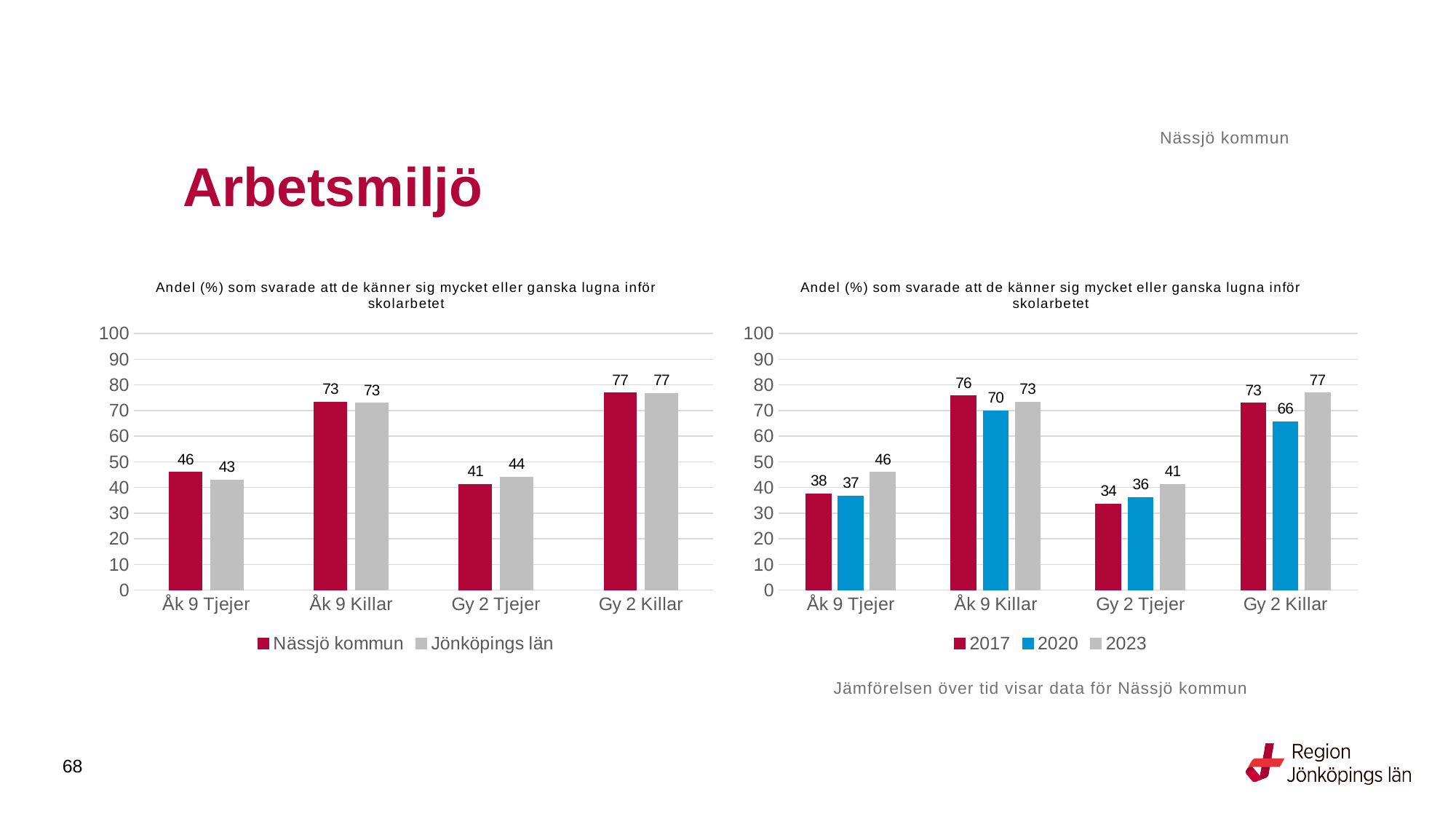
In the right chart, what is the value for 2020 for Åk 9 Killar? 70 In the left chart, what is the value for Jönköpings län for Gy 2 Tjejer? 44 In the left chart, how many series does the legend list? 2 In the right chart, what is the difference between the 2023 and 2017 values for Åk 9 Tjejer? 8 In the right chart, what is the value for 2023 for Gy 2 Tjejer? 41 In the left chart, what is the value for Nässjö kommun for Åk 9 Tjejer? 46 In the left chart, which category has the lowest value for Jönköpings län? Åk 9 Tjejer In the right chart, which is larger for Åk 9 Killar: the 2017 value or the 2023 value? 2017 In the left chart, what is the difference between Nässjö kommun and Jönköpings län for Åk 9 Tjejer? 3 What kind of chart is the right chart? Bar chart In the right chart, which year has the lowest value for Gy 2 Killar? 2020 In the left chart, which category has the highest value for Nässjö kommun? Gy 2 Killar